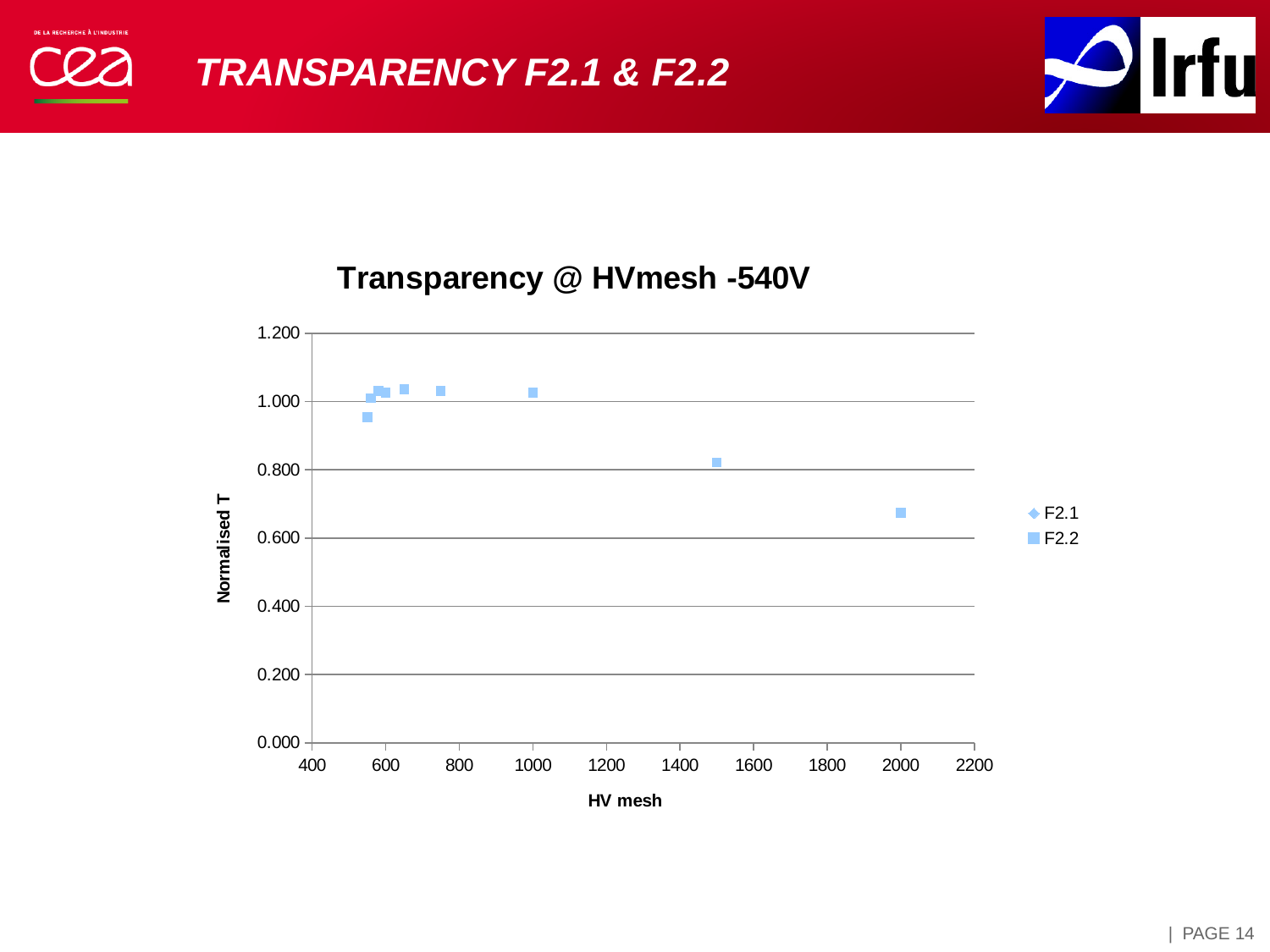
How many series does the legend list? 2 Is the Normalised T value at HV mesh 2000 greater or less than 0.600? greater Is the Normalised T value at HV mesh 1000 greater or less than 0.800? greater Which has the larger Normalised T: the point at HV mesh 1000 or the point at HV mesh 1500? HV mesh 1000 Do the Normalised T values rise or fall as HV mesh increases from 1000 to 2000? fall What is the title of the chart? Transparency @ HVmesh -540V At which HV mesh value is the Normalised T lowest? 2000 Which series is shown with a square marker in the legend? F2.2 Is the Normalised T value at HV mesh 1500 greater or less than 1.000? less What is the label of the y axis? Normalised T What kind of chart is shown on the slide? scatter chart